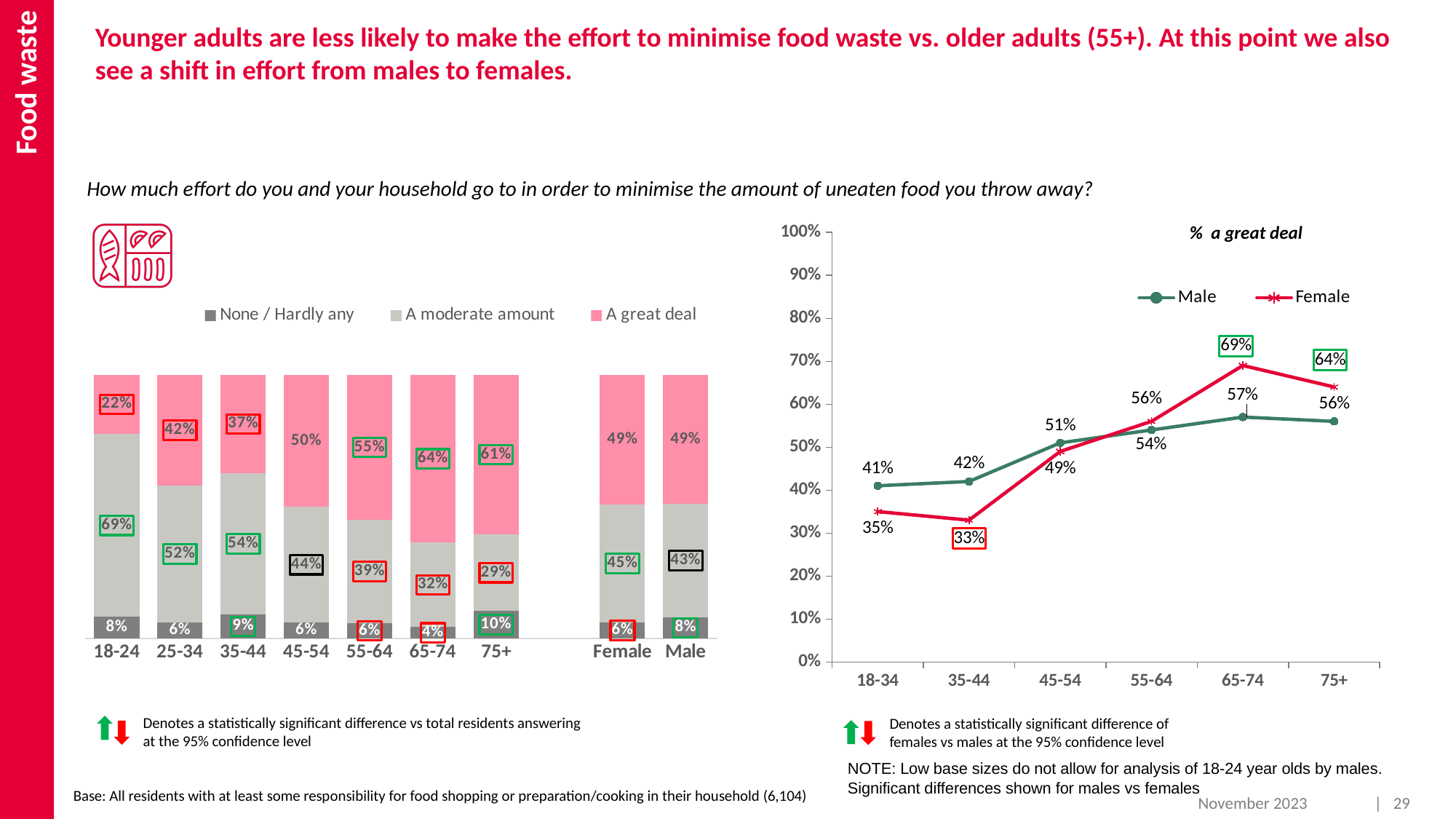
In the stacked bar chart on the left, which age group has the highest 'A great deal' percentage? 65-74 In the stacked bar chart on the left, what percentage of 18-24 year olds say they go to 'A great deal' of effort? 22% How many series does the legend of the stacked bar chart on the left list? 3 In the stacked bar chart on the left, which age group has the lowest 'A moderate amount' percentage? 75+ How many age groups are shown on the x axis of the '% a great deal' line chart on the right? 6 In the stacked bar chart on the left, what is the difference between the 'A moderate amount' percentages for Female and Male? 2% In the '% a great deal' line chart on the right, what is the difference between the Female and Male values for 75+? 8% In the '% a great deal' line chart on the right, what is the Female value for 65-74? 69% What type of chart is the '% a great deal' chart on the right? Line chart In the stacked bar chart on the left, what percentage of 65-74 year olds say 'None / Hardly any'? 4% In the '% a great deal' line chart on the right, what is the Male value for 18-34? 41% In the '% a great deal' line chart on the right, which is larger for 35-44: the Male value or the Female value? Male